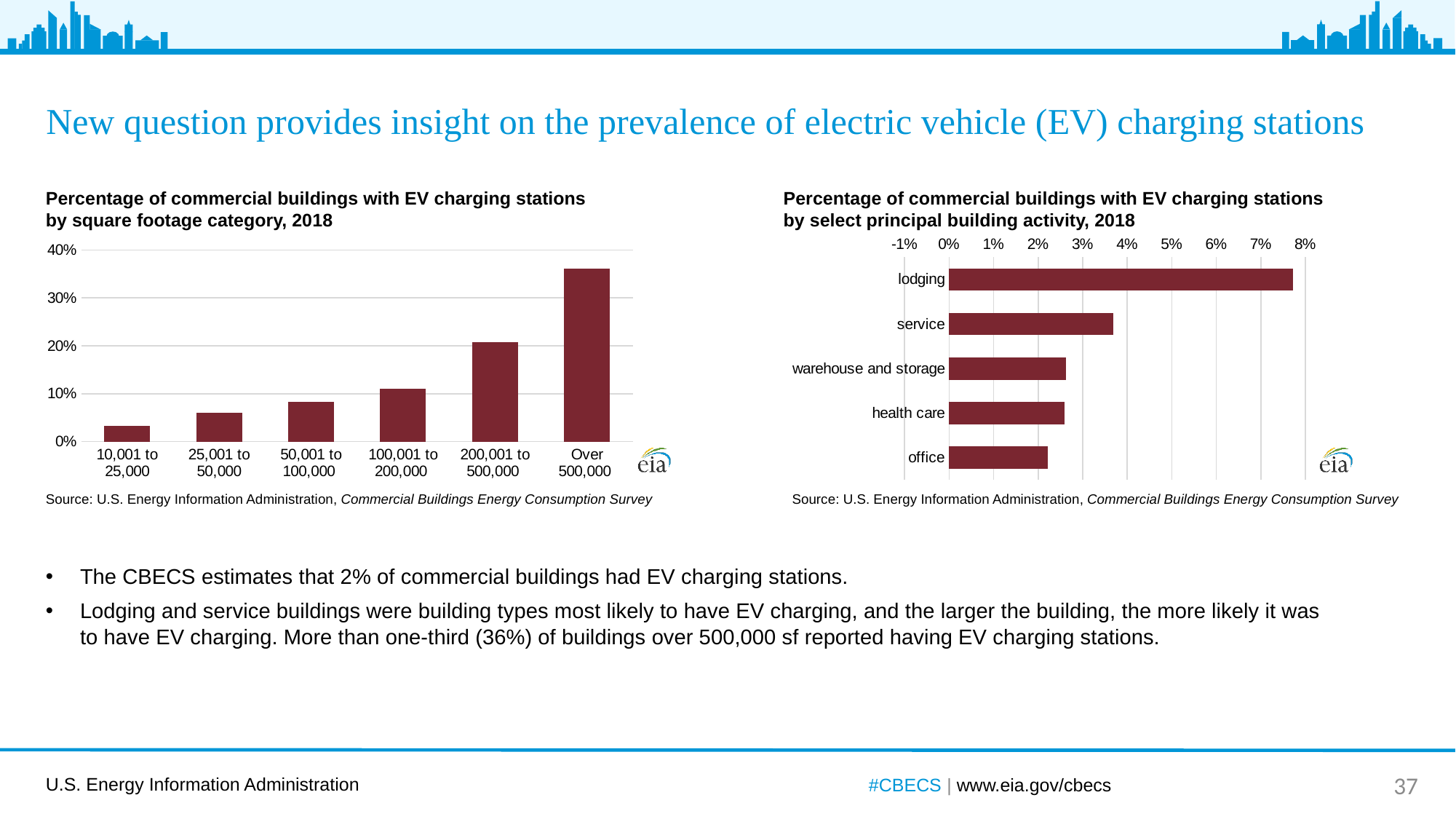
In the chart 'Percentage of commercial buildings with EV charging stations by square footage category, 2018', what kind of chart is shown? bar chart In the chart 'Percentage of commercial buildings with EV charging stations by select principal building activity, 2018', is the value for lodging greater or less than 7%? greater In the chart 'Percentage of commercial buildings with EV charging stations by square footage category, 2018', which category has the highest percentage? Over 500,000 In the chart 'Percentage of commercial buildings with EV charging stations by square footage category, 2018', which category has the lowest percentage? 10,001 to 25,000 In the chart 'Percentage of commercial buildings with EV charging stations by square footage category, 2018', which is larger: the value for 200,001 to 500,000 or the value for 100,001 to 200,000? 200,001 to 500,000 In the chart 'Percentage of commercial buildings with EV charging stations by select principal building activity, 2018', how many building activities are plotted? 5 In the chart 'Percentage of commercial buildings with EV charging stations by square footage category, 2018', how many square footage categories are plotted? 6 In the chart 'Percentage of commercial buildings with EV charging stations by square footage category, 2018', is the value for Over 500,000 greater or less than 30%? greater In the chart 'Percentage of commercial buildings with EV charging stations by select principal building activity, 2018', which building activity has the lowest percentage? office In the chart 'Percentage of commercial buildings with EV charging stations by select principal building activity, 2018', which building activity has the highest percentage? lodging In the chart 'Percentage of commercial buildings with EV charging stations by square footage category, 2018', do the values rise or fall as square footage increases along the x axis? rise In the chart 'Percentage of commercial buildings with EV charging stations by square footage category, 2018', is the value for 50,001 to 100,000 greater or less than 10%? less